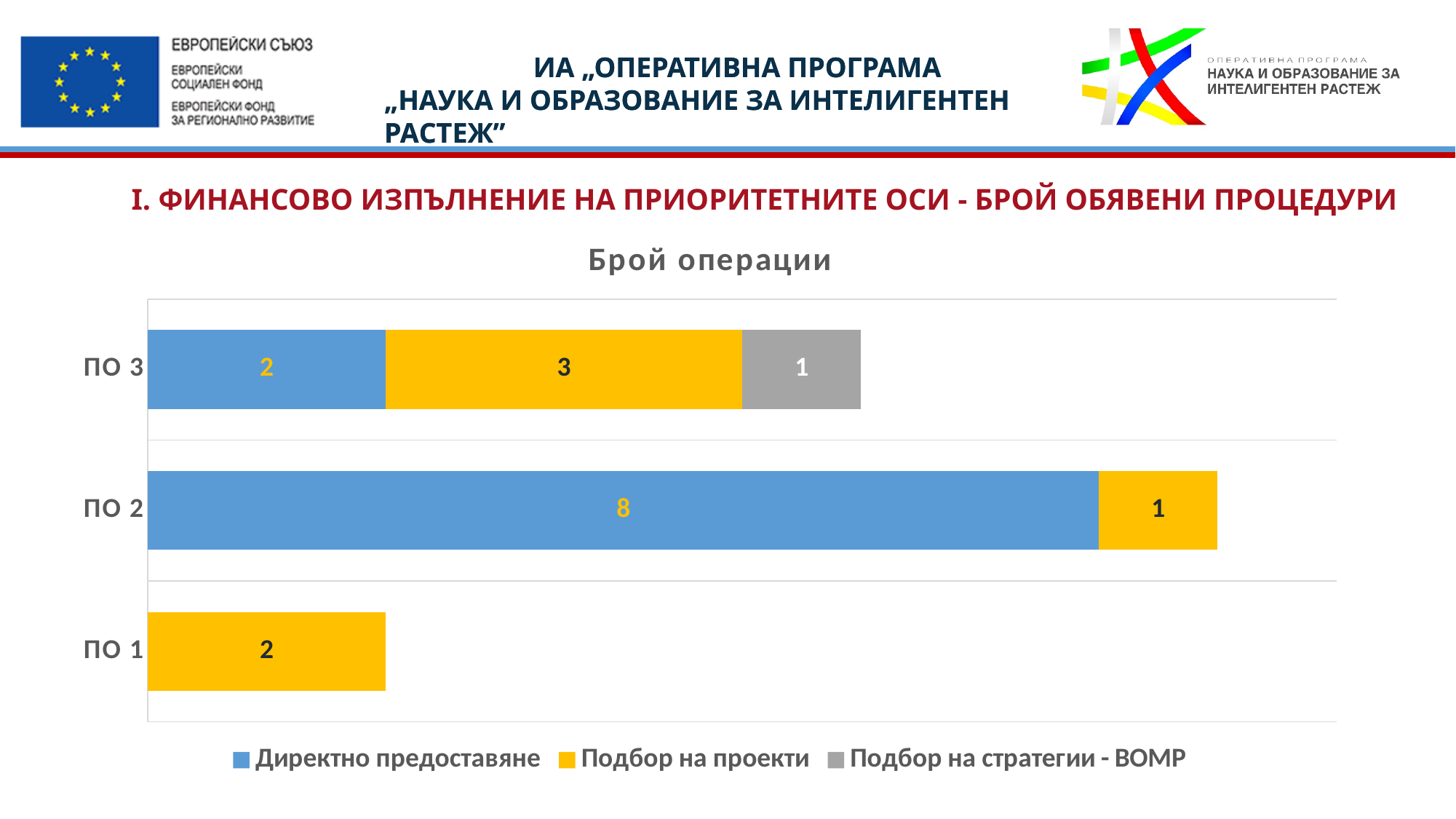
What is the value for Директно предоставяне for ПО 2? 8 What is the value for Подбор на проекти for ПО 3? 3 What is the total of the stacked bar for ПО 3? 6 Which is larger: Подбор на проекти for ПО 3 or Подбор на проекти for ПО 2? ПО 3 Which category has the highest value for Директно предоставяне? ПО 2 What is the difference between the Директно предоставяне values for ПО 2 and ПО 3? 6 What is the value for Директно предоставяне for ПО 3? 2 What is the value for Подбор на проекти for ПО 1? 2 How many series does the legend list? 3 What is the total of the stacked bar for ПО 2? 9 What is the value for Подбор на стратегии - ВОМР for ПО 3? 1 What type of chart is shown? Stacked bar chart